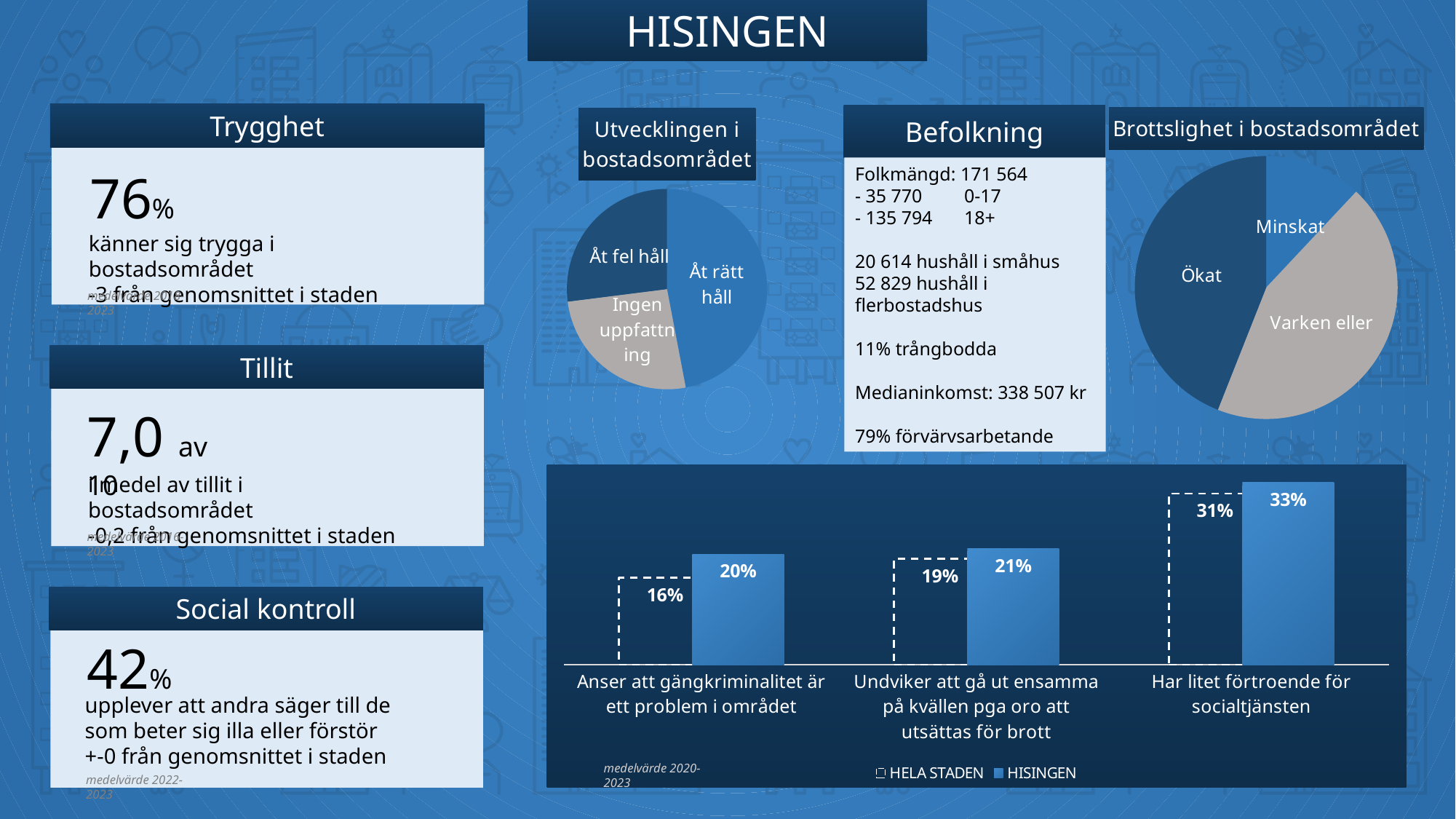
What kind of chart is the chart titled 'Brottslighet i bostadsområdet'? Pie chart In the bar chart at the bottom of the slide, which category has the lowest value for HELA STADEN? Anser att gängkriminalitet är ett problem i området What kind of chart is the chart at the bottom of the slide? Bar chart How many series does the legend of the bar chart at the bottom of the slide list? 2 How many slices does the pie chart titled 'Utvecklingen i bostadsområdet' have? 3 In the bar chart at the bottom of the slide, what is the value for HELA STADEN for 'Anser att gängkriminalitet är ett problem i området'? 16% In the bar chart at the bottom of the slide, which category has the highest value for HISINGEN? Har litet förtroende för socialtjänsten In the bar chart at the bottom of the slide, what is the value for HISINGEN for 'Undviker att gå ut ensamma på kvällen pga oro att utsättas för brott'? 21% In the bar chart at the bottom of the slide, what is the difference between HISINGEN and HELA STADEN for 'Anser att gängkriminalitet är ett problem i området'? 4% How many categories are shown in the bar chart at the bottom of the slide? 3 In the bar chart at the bottom of the slide, which is larger for 'Undviker att gå ut ensamma på kvällen pga oro att utsättas för brott': HELA STADEN or HISINGEN? HISINGEN In the bar chart at the bottom of the slide, what is the value for HISINGEN for 'Har litet förtroende för socialtjänsten'? 33%